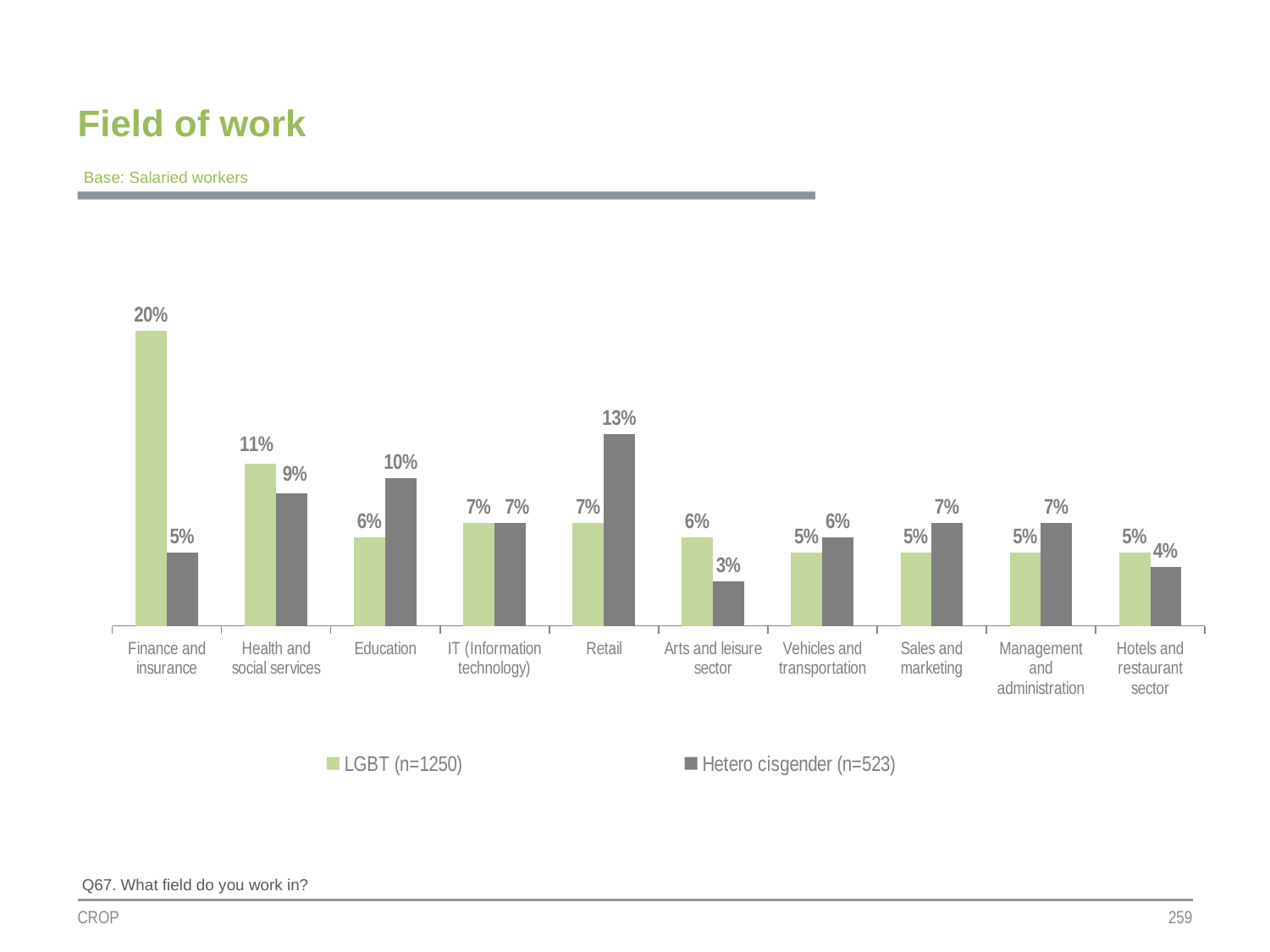
What is the title of the slide? Field of work In Education, which series has the larger value, LGBT (n=1250) or Hetero cisgender (n=523)? Hetero cisgender (n=523) What is the value for Hetero cisgender (n=523) in Arts and leisure sector? 3% Which field has the lowest value for Hetero cisgender (n=523)? Arts and leisure sector What is the difference between the Hetero cisgender (n=523) and LGBT (n=1250) values in Retail? 6% What is the value for Hetero cisgender (n=523) in Retail? 13% What is the value for LGBT (n=1250) in Finance and insurance? 20% How many series does the legend list? 2 Which field has the highest value for LGBT (n=1250)? Finance and insurance What kind of chart is shown on the slide? Bar chart How many fields of work are shown on the x axis? 10 What is the difference between the LGBT (n=1250) and Hetero cisgender (n=523) values in Finance and insurance? 15%